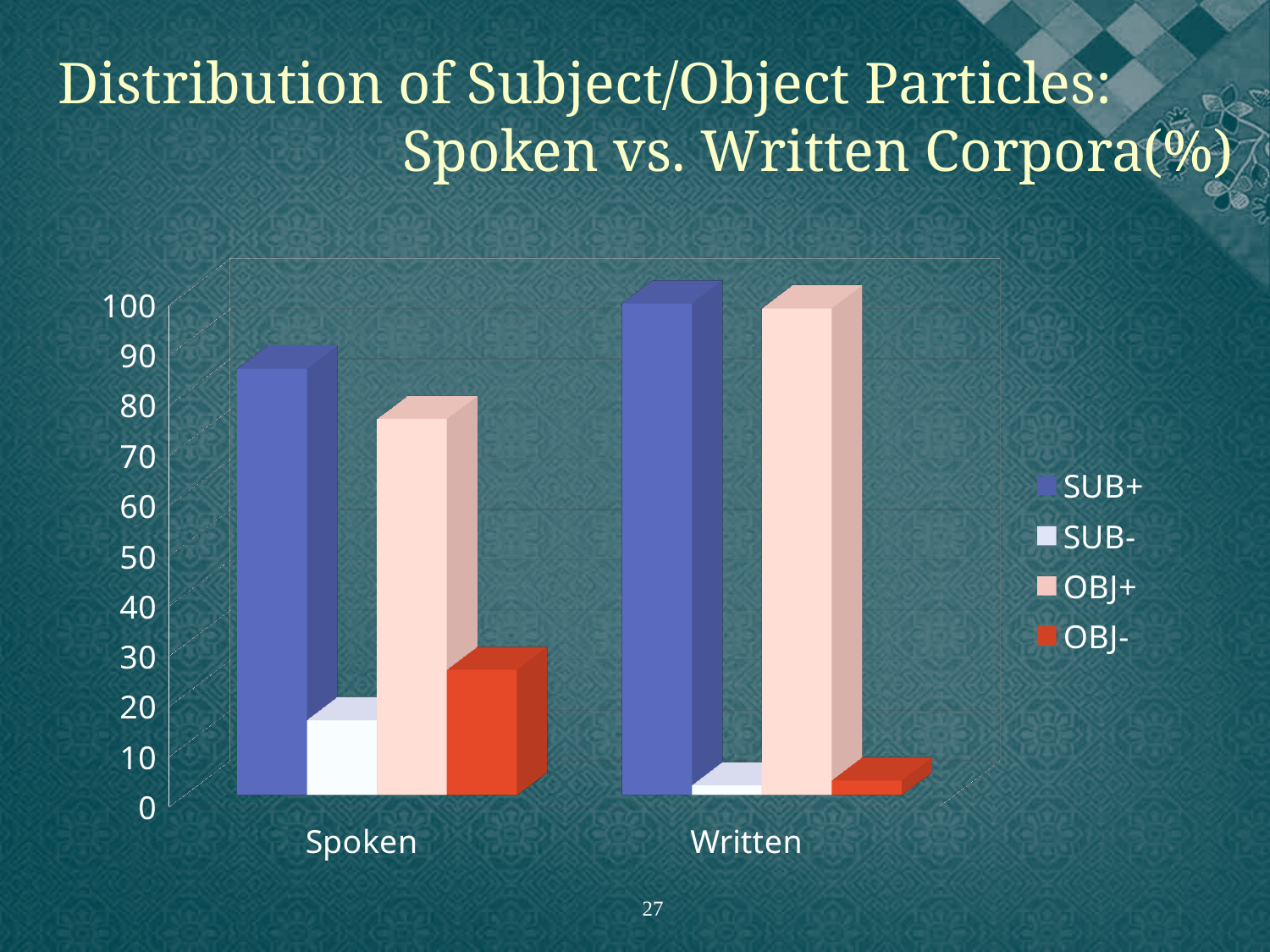
Is the value for OBJ- in the Spoken category greater or less than 30? less Is the value for OBJ+ in the Written category greater or less than 90? greater Is the value for SUB+ in the Spoken category greater or less than 80? greater How many series does the legend list? 4 Which series is shown in red in the legend? OBJ- Which is larger in the Spoken category, OBJ+ or OBJ-? OBJ+ What kind of chart is shown on the slide? bar chart How many categories are shown on the x axis? 2 Which series has the highest value in the Spoken category? SUB+ Which series has the lowest value in the Spoken category? SUB- Which series has the lowest value in the Written category? SUB-